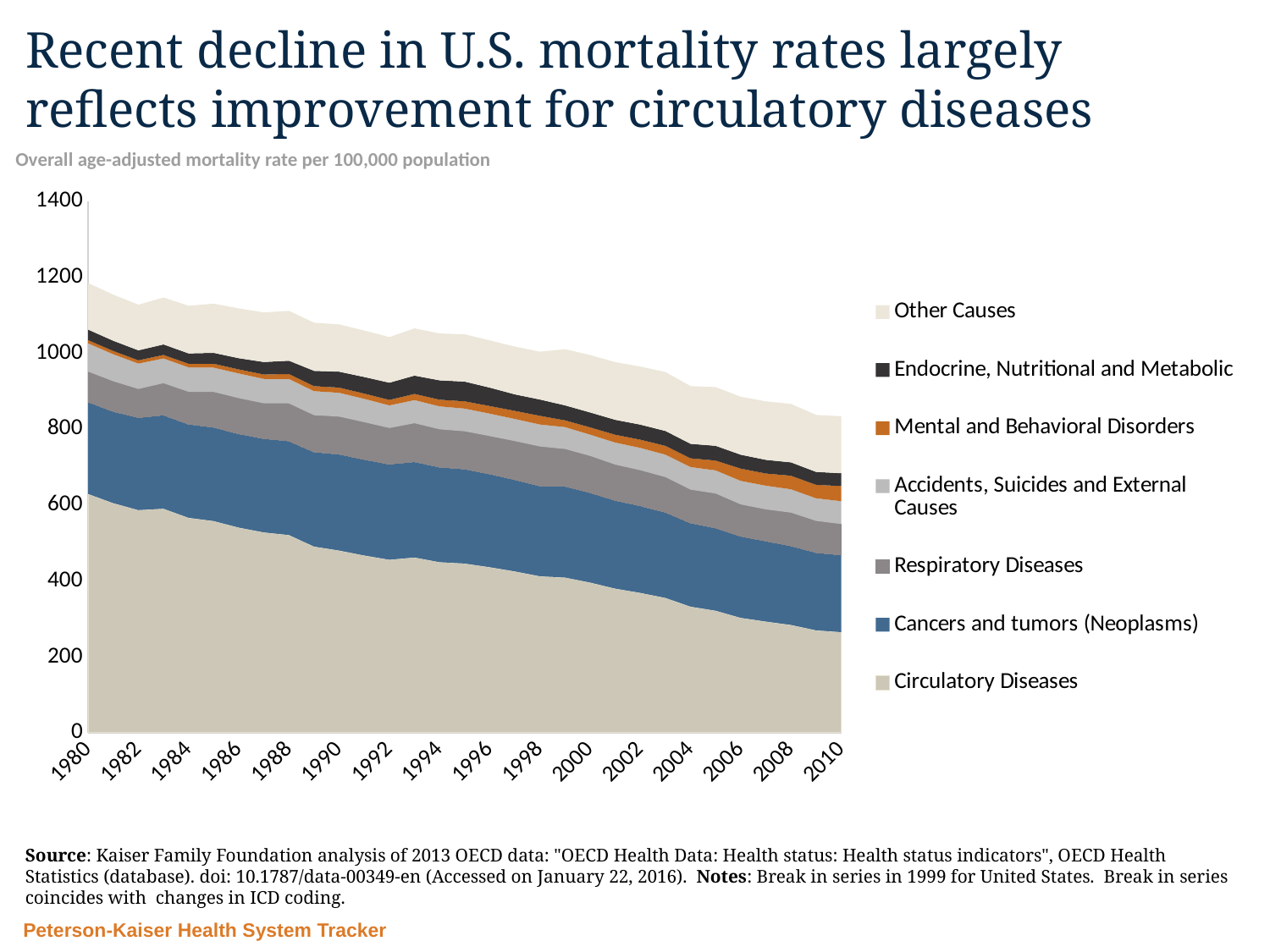
Is the overall mortality rate in 1990 greater or less than 1200? less How many year labels are shown on the x axis? 16 What is the subtitle describing the measure plotted on the chart? Overall age-adjusted mortality rate per 100,000 population What kind of chart is shown on the slide? Stacked area chart Which series is at the bottom of the stacked area? Circulatory Diseases Which year has the higher overall mortality rate, 1980 or 2010? 1980 Is the overall mortality rate in 1980 greater or less than 1000? greater How many series does the legend list? 7 Does the overall mortality rate (top of the stacked area) rise or fall from 1980 to 2010? Fall Is the overall mortality rate in 2010 greater or less than 1000? less